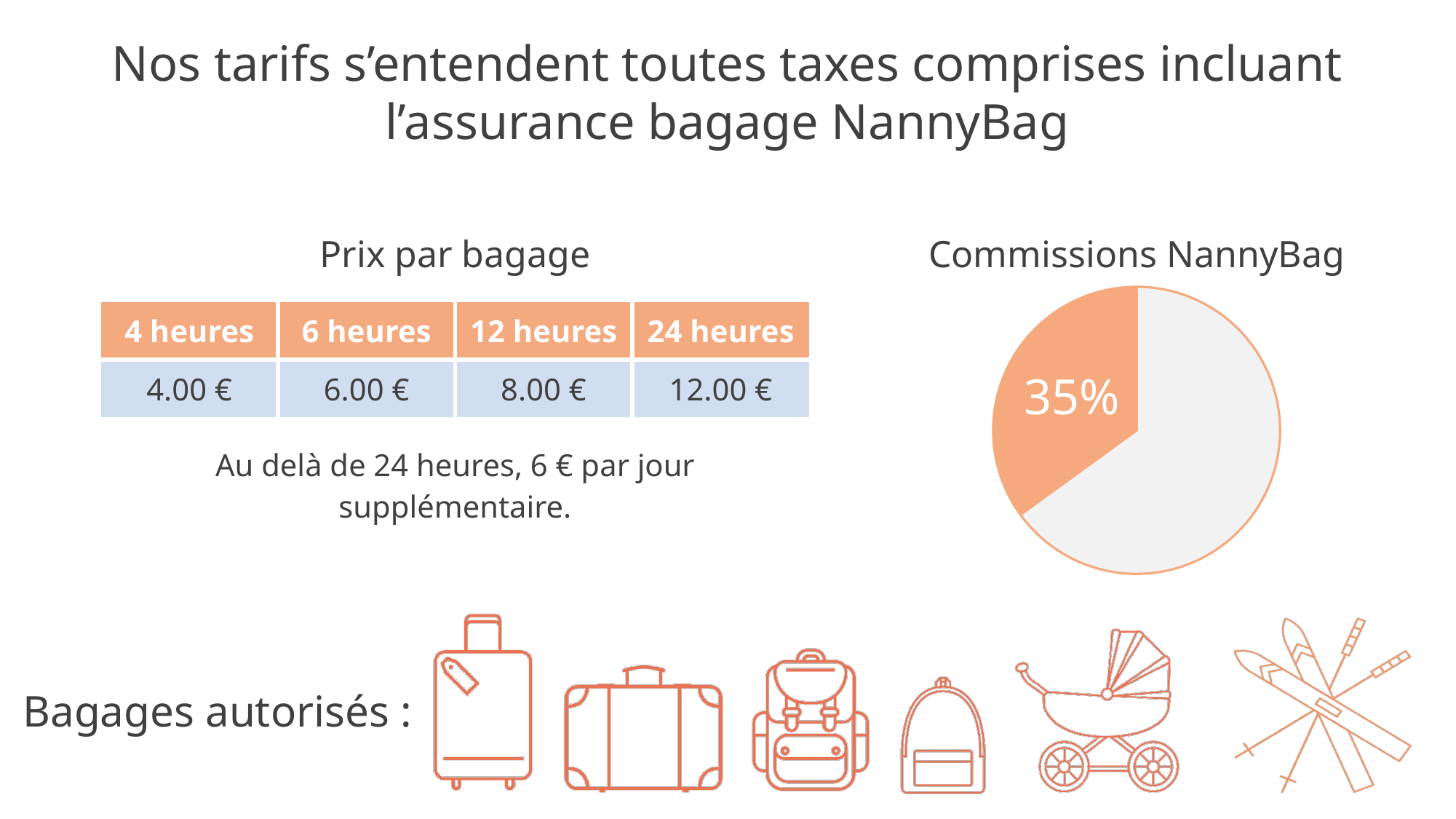
How many slices does the "Commissions NannyBag" pie chart have? 2 In the "Commissions NannyBag" pie chart, is the orange slice greater or less than 50% of the pie? less In the "Commissions NannyBag" pie chart, what share is shown on the orange slice? 35% In the "Commissions NannyBag" pie chart, what colour is the slice labelled 35%? orange What is the title of the pie chart on the slide? Commissions NannyBag What kind of chart is shown under the heading "Commissions NannyBag"? pie chart In the "Commissions NannyBag" pie chart, which slice is larger, the orange one or the grey one? the grey one